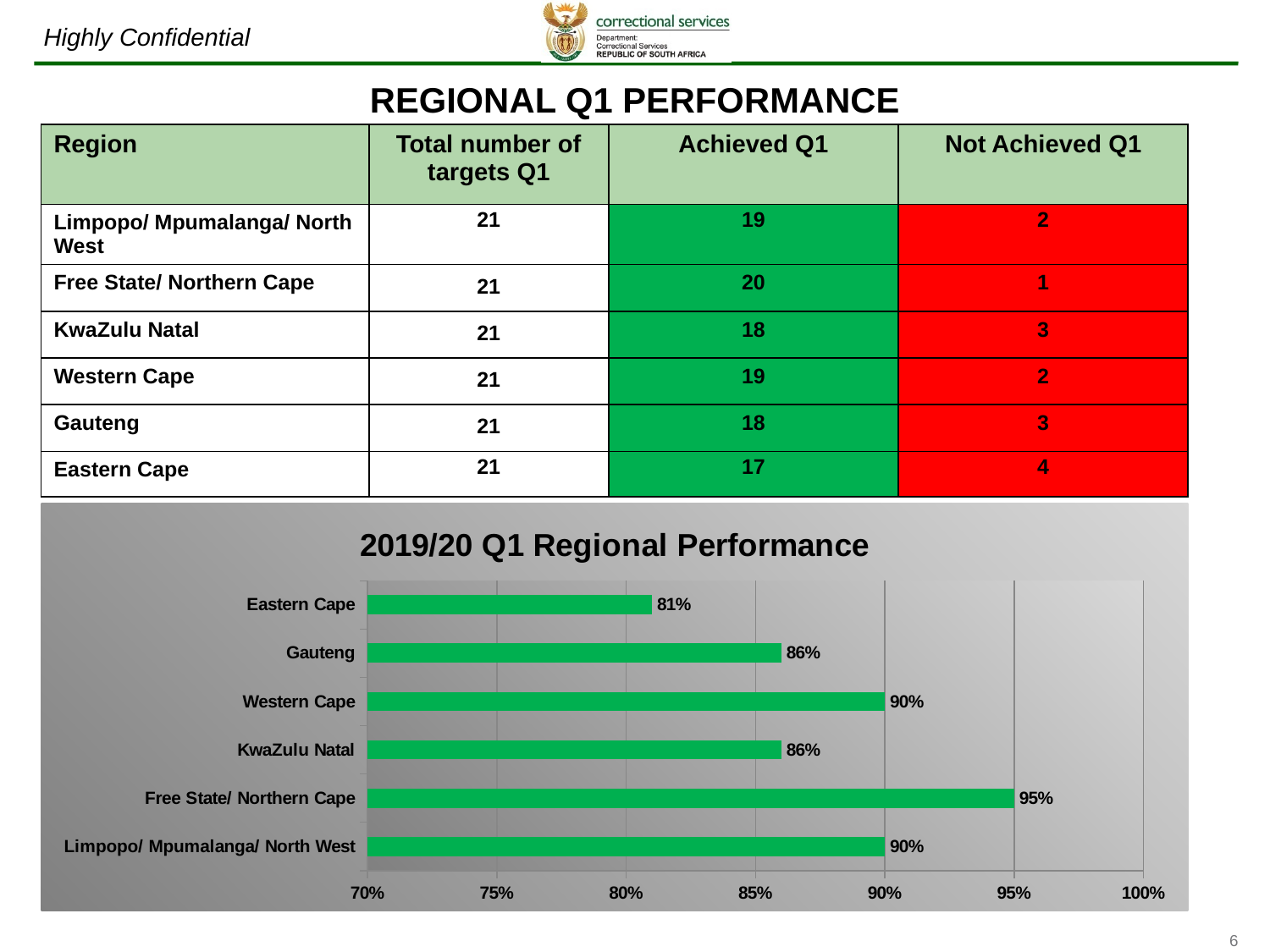
Is the value for Gauteng in the chart greater or less than 90%? less What is the value for Western Cape in the chart? 90% What is the title of the chart on the slide? 2019/20 Q1 Regional Performance What is the value for Eastern Cape in the 2019/20 Q1 Regional Performance chart? 81% What kind of chart is shown on the slide? bar chart Which region has the lowest value in the chart? Eastern Cape How many regions are shown in the chart? 6 What is the difference between the values for Western Cape and KwaZulu Natal in the chart? 4% Which is larger in the chart, the value for Gauteng or the value for Western Cape? Western Cape Which region has the highest value in the chart? Free State/ Northern Cape What is the difference between the values for Free State/ Northern Cape and Eastern Cape in the chart? 14% What is the value for Free State/ Northern Cape in the chart? 95%